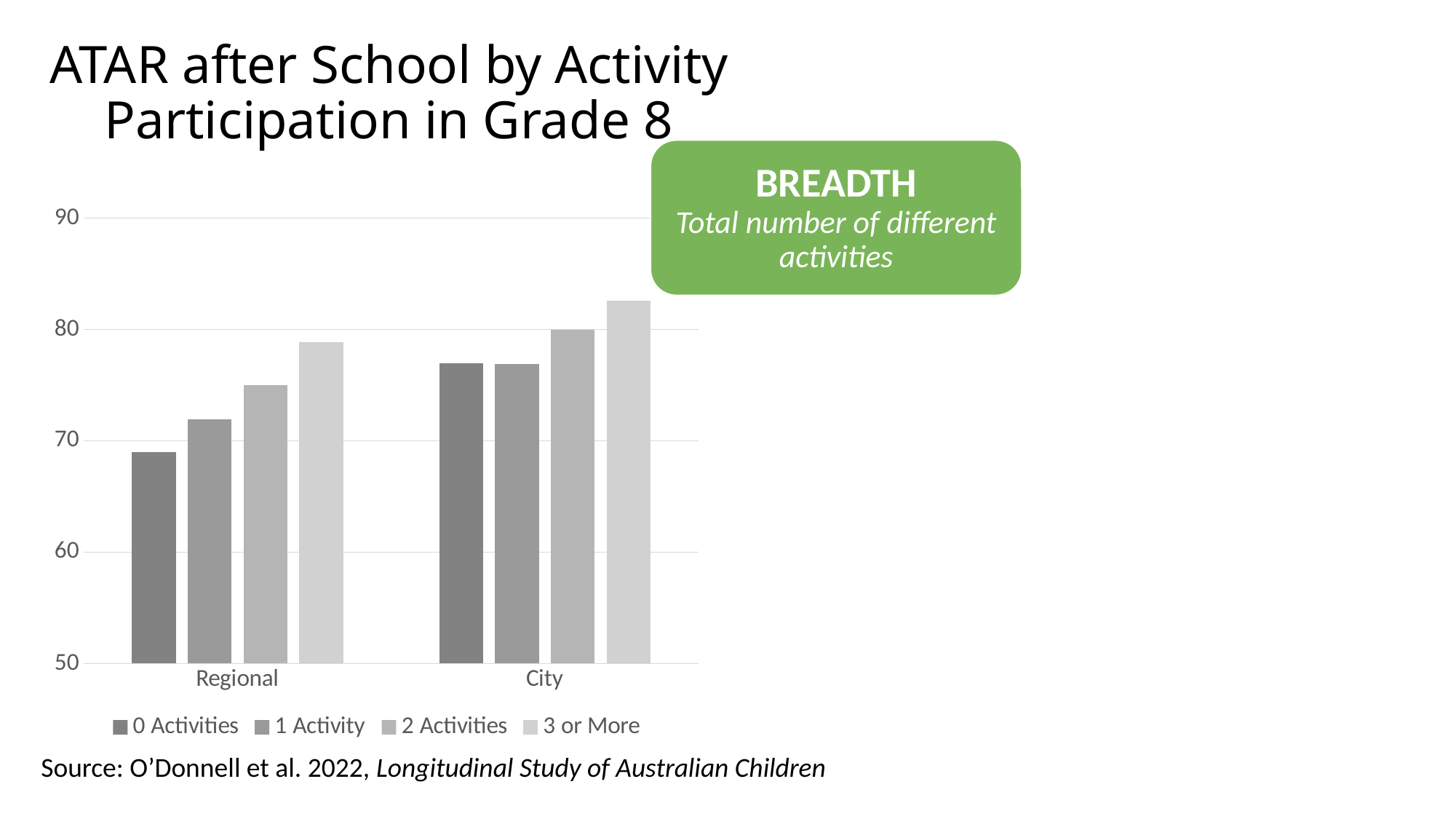
What is the title of the chart on the slide? ATAR after School by Activity Participation in Grade 8 Which is larger: the value for 0 Activities in Regional or the value for 0 Activities in City? 0 Activities in City Which activity group has the lowest ATAR in the Regional category? 0 Activities How many series does the legend list? 4 Do the values rise or fall from 0 Activities to 3 or More within the Regional category? rise Which activity group has the highest ATAR in the City category? 3 or More Is the value for 0 Activities in the Regional category greater or less than 70? less What kind of chart is shown on the slide? bar chart How many categories are shown on the x axis? 2 Is the value for 3 or More in the City category greater or less than 80? greater Which activity group has the highest ATAR in the Regional category? 3 or More Is the value for 2 Activities in the Regional category greater or less than 70? greater